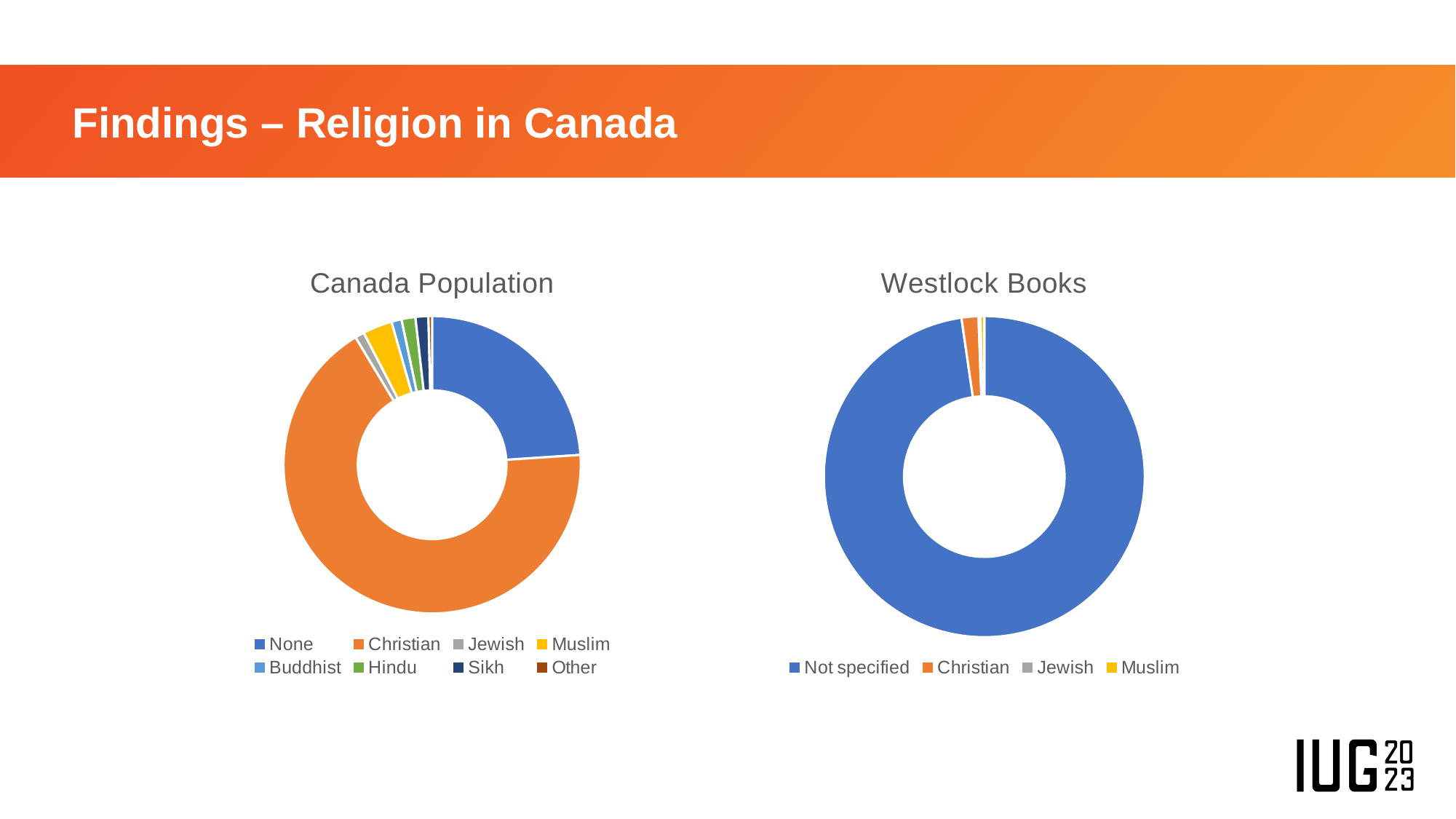
In the Westlock Books chart, which category has the largest slice? Not specified In the Westlock Books chart, how many categories does the legend list? 4 In the Canada Population chart, how many categories does the legend list? 8 In the Canada Population chart, which slice is larger, Muslim or Buddhist? Muslim In the Westlock Books chart, which slice is larger, Not specified or Christian? Not specified In the Canada Population chart, which slice is larger, None or Christian? Christian In the Westlock Books chart, what colour represents the Christian category? Orange What is the title of the chart on the left side of the slide? Canada Population In the Canada Population chart, which category has the largest slice? Christian What kind of chart is the Canada Population chart? Pie chart (donut) What kind of chart is the Westlock Books chart? Pie chart (donut)